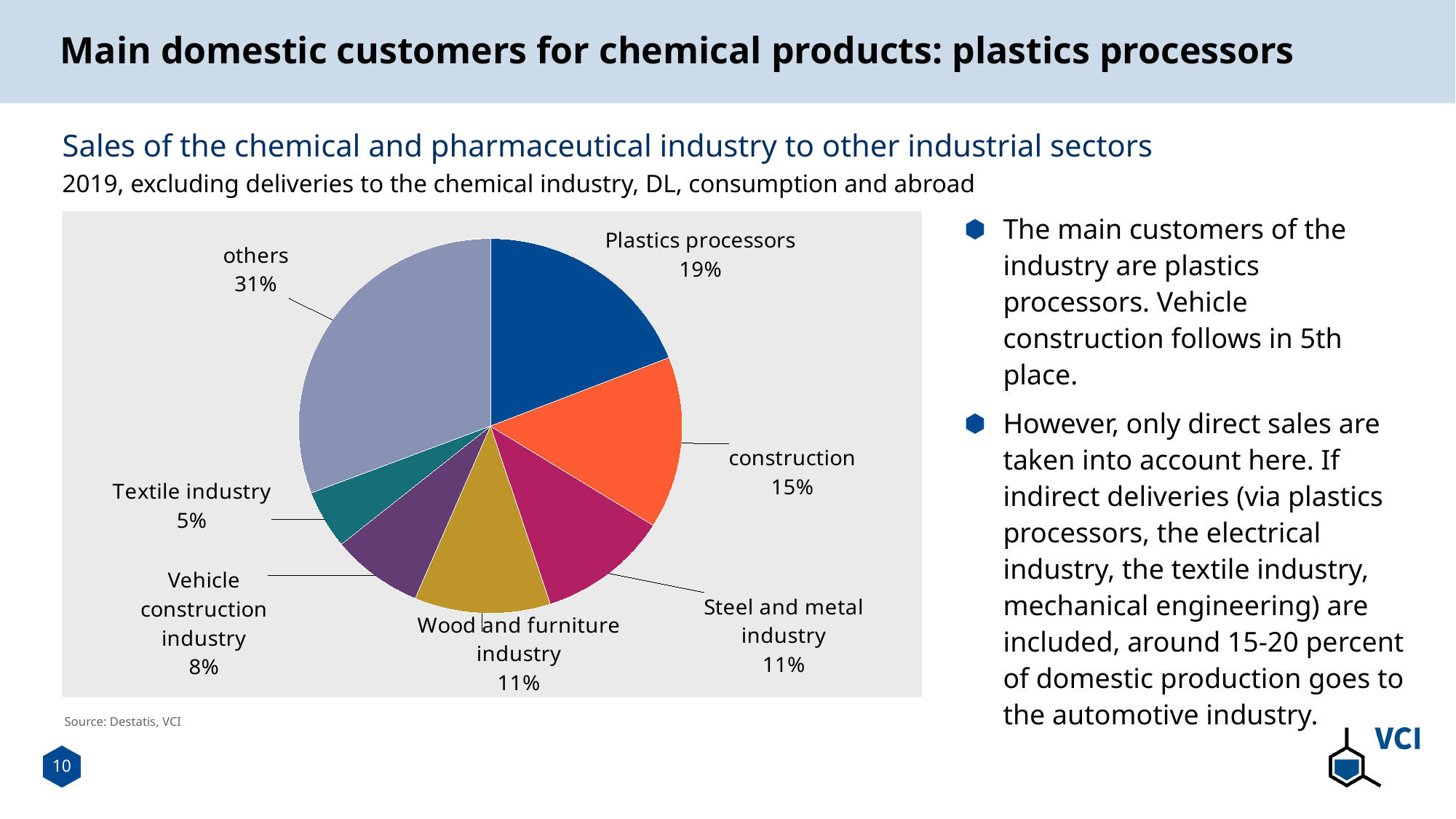
Which sector has the smallest share of sales? Textile industry What share of sales goes to the vehicle construction industry? 8% What share of sales goes to the textile industry? 5% What is the difference in percentage points between the plastics processors share and the construction share? 4 percentage points What is the combined share of the steel and metal industry and the wood and furniture industry? 22% What share of sales goes to the construction sector? 15% Which named industrial sector (excluding 'others') has the largest share of sales? Plastics processors Which has a larger share of sales, the vehicle construction industry or the textile industry? Vehicle construction industry What share of sales is labelled 'others'? 31% What share of sales goes to plastics processors? 19% What kind of chart is shown on the slide? pie chart How many slices does the pie chart have? 7